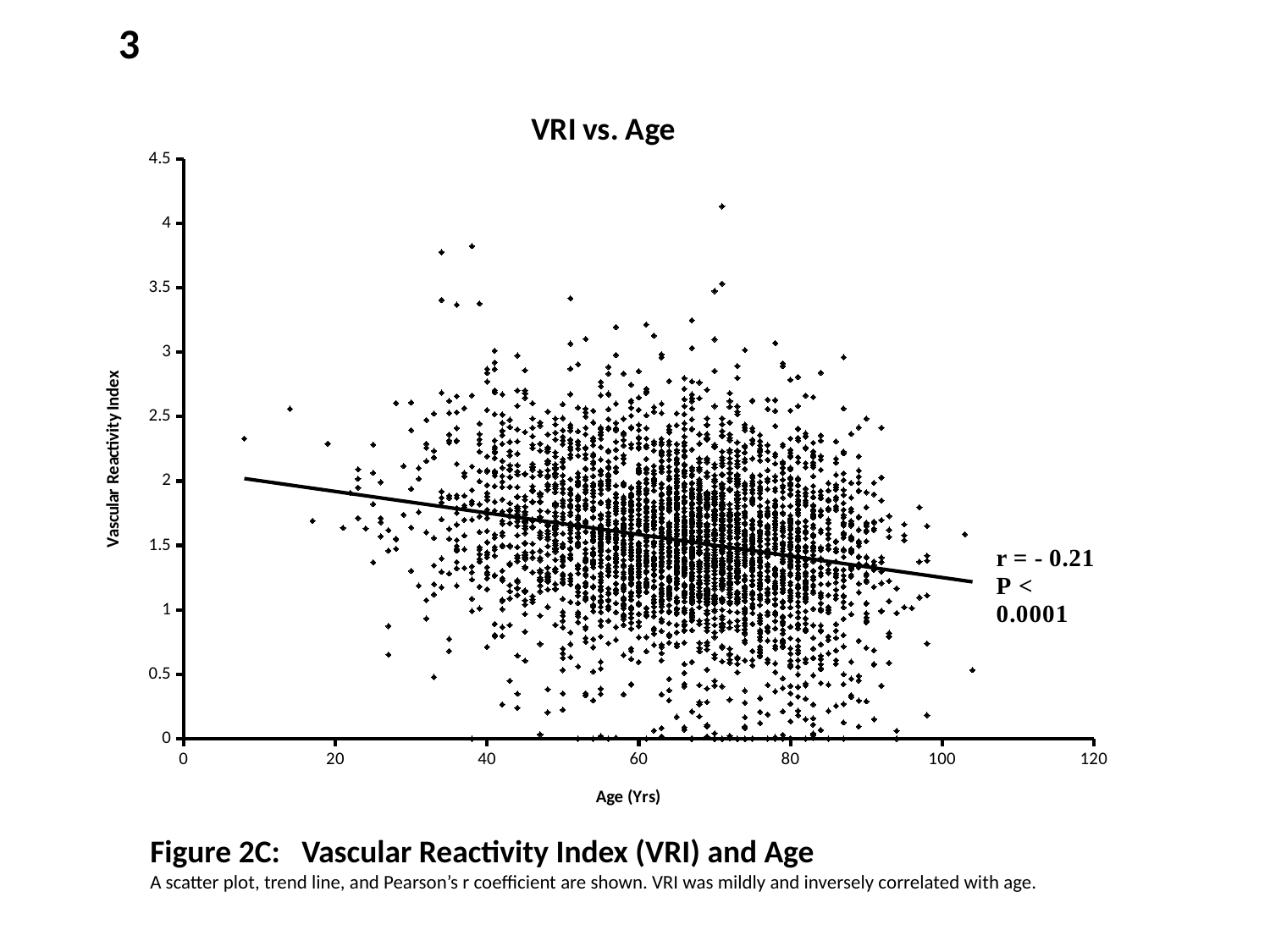
Is the highest plotted Vascular Reactivity Index value greater or less than 4? greater Does the trend line rise or fall as age increases? fall Is the trend line higher at age 20 or at age 100? age 20 What P value is printed on the chart? P < 0.0001 What is the title of the chart? VRI vs. Age What Pearson's r coefficient is printed on the chart? r = - 0.21 Is the trend line value at age 100 greater or less than 1.5? less What kind of chart is shown on the slide? scatter plot Is the trend line value at age 20 greater or less than 1.5? greater What is the label of the x axis? Age (Yrs)